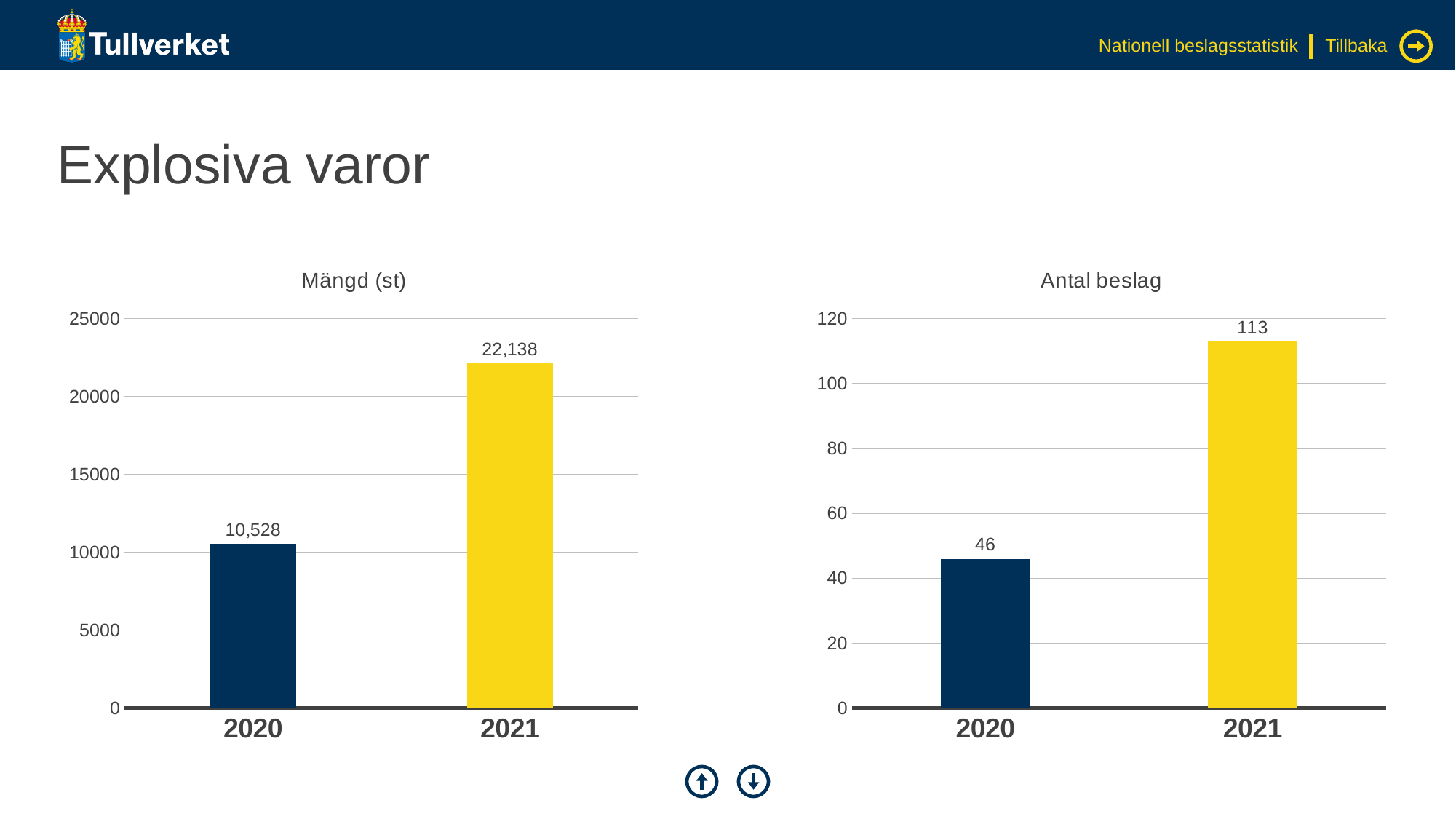
In the 'Mängd (st)' chart, what is the value for 2020? 10,528 In the 'Mängd (st)' chart, what is the value for 2021? 22,138 In the 'Mängd (st)' chart, what is the difference between the 2021 and 2020 values? 11,610 In the 'Antal beslag' chart, what is the difference between the 2021 and 2020 values? 67 How many years are shown in the 'Mängd (st)' chart? 2 In the 'Mängd (st)' chart, do the values rise or fall from 2020 to 2021? rise What kind of chart is the 'Antal beslag' chart? bar chart In the 'Antal beslag' chart, is the value for 2021 greater or less than 100? greater In the 'Antal beslag' chart, what is the value for 2020? 46 In the 'Mängd (st)' chart, which year has the lowest value? 2020 In the 'Antal beslag' chart, which year has the highest value? 2021 In the 'Antal beslag' chart, what is the value for 2021? 113